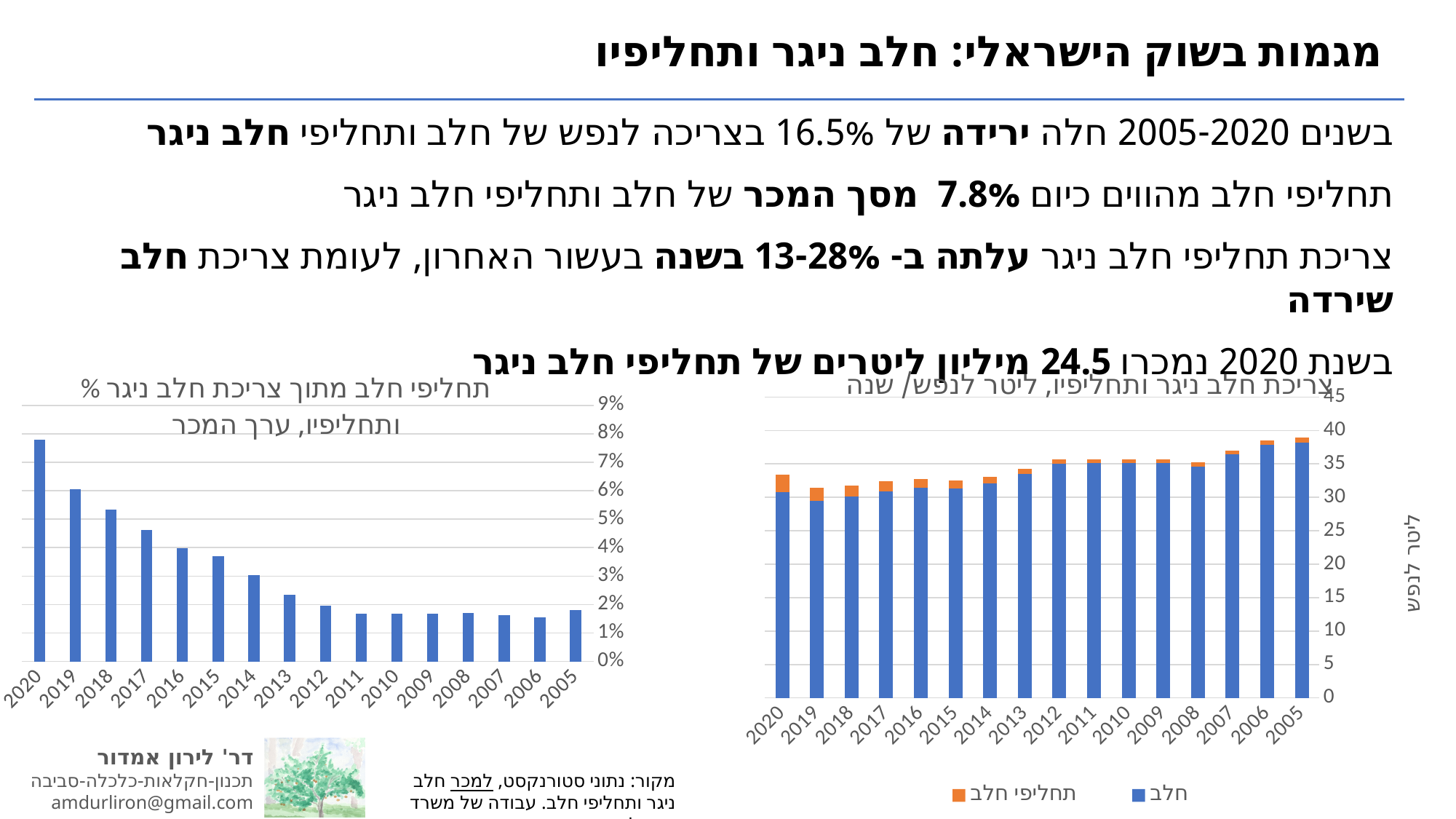
What kind of chart is the left chart (תחליפי חלב מתוך צריכת חלב ניגר ותחליפיו, ערך המכר %)? Bar chart In the right chart (צריכת חלב ניגר ותחליפיו, ליטר לנפש/ שנה), is the total for 2005 greater or less than 35? greater In the left chart (תחליפי חלב מתוך צריכת חלב ניגר ותחליפיו), is the value for 2020 greater or less than 7%? greater In the left chart (תחליפי חלב מתוך צריכת חלב ניגר ותחליפיו), is the value for 2017 greater or less than 4%? greater In the left chart (תחליפי חלב מתוך צריכת חלב ניגר ותחליפיו), does the share rise or fall as the years go from 2005 to 2020? Rise How many series does the legend of the right chart (צריכת חלב ניגר ותחליפיו, ליטר לנפש/ שנה) list? 2 How many years are shown on the x axis of the left chart (תחליפי חלב מתוך צריכת חלב ניגר ותחליפיו)? 16 In the right chart (צריכת חלב ניגר ותחליפיו, ליטר לנפש/ שנה), which year has the highest total bar? 2005 In the left chart (תחליפי חלב מתוך צריכת חלב ניגר ותחליפיו), which year has the highest value? 2020 In the right chart (צריכת חלב ניגר ותחליפיו, ליטר לנפש/ שנה), which total bar is larger, 2005 or 2020? 2005 In the right chart (צריכת חלב ניגר ותחליפיו, ליטר לנפש/ שנה), which colour represents תחליפי חלב in the legend? Orange